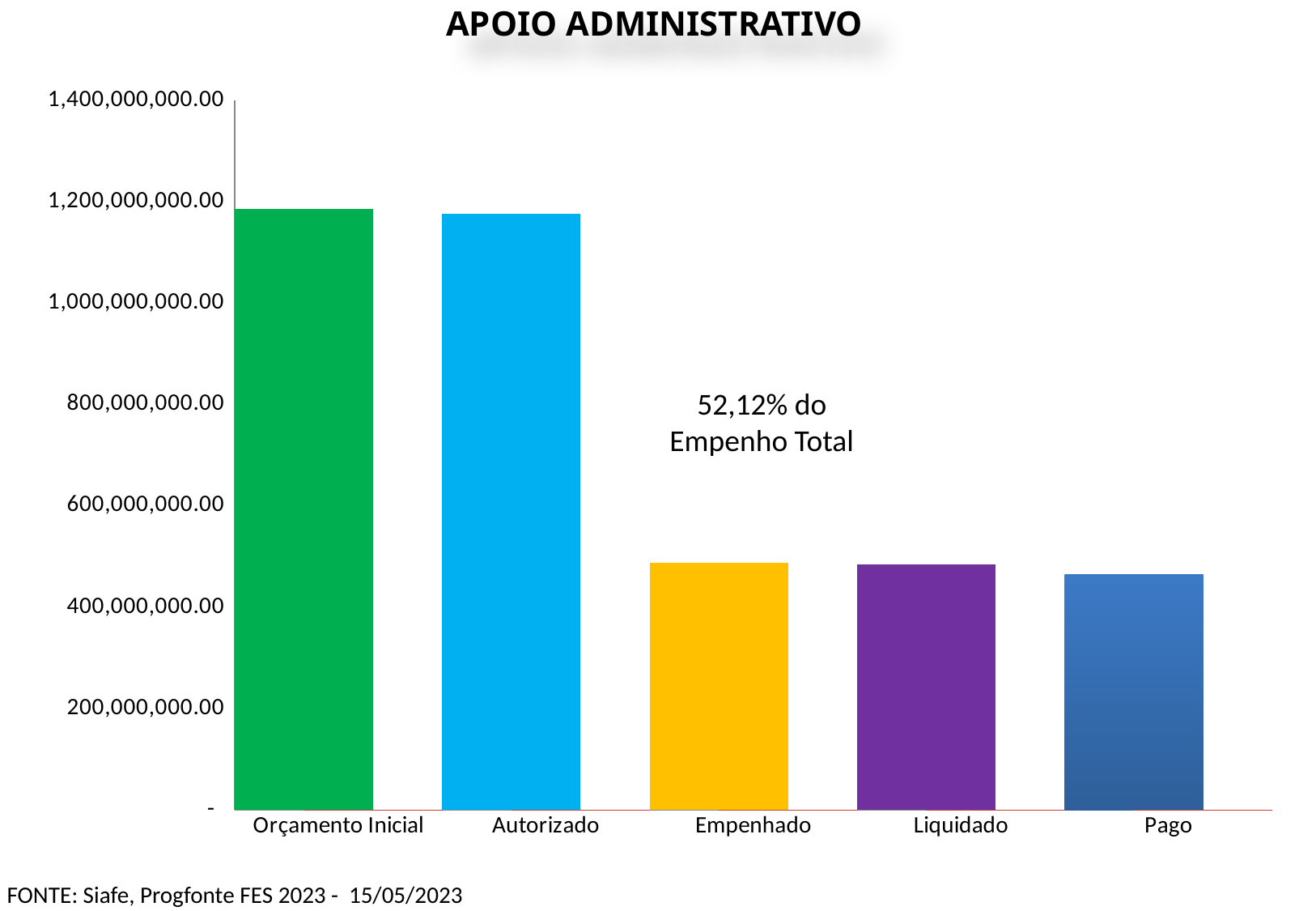
Is the value for Empenhado greater or less than 600,000,000.00? less What percentage annotation is printed inside the chart area? 52,12% do Empenho Total Is the value for Liquidado greater or less than 400,000,000.00? greater Do the values generally rise or fall from Orçamento Inicial to Pago along the x axis? fall Is the value for Autorizado greater or less than 1,200,000,000.00? less What kind of chart is shown on the slide? bar chart Which is larger, the value for Orçamento Inicial or the value for Pago? Orçamento Inicial Which is larger, the value for Autorizado or the value for Empenhado? Autorizado How many categories are plotted on the x axis? 5 What is the title of the chart? APOIO ADMINISTRATIVO